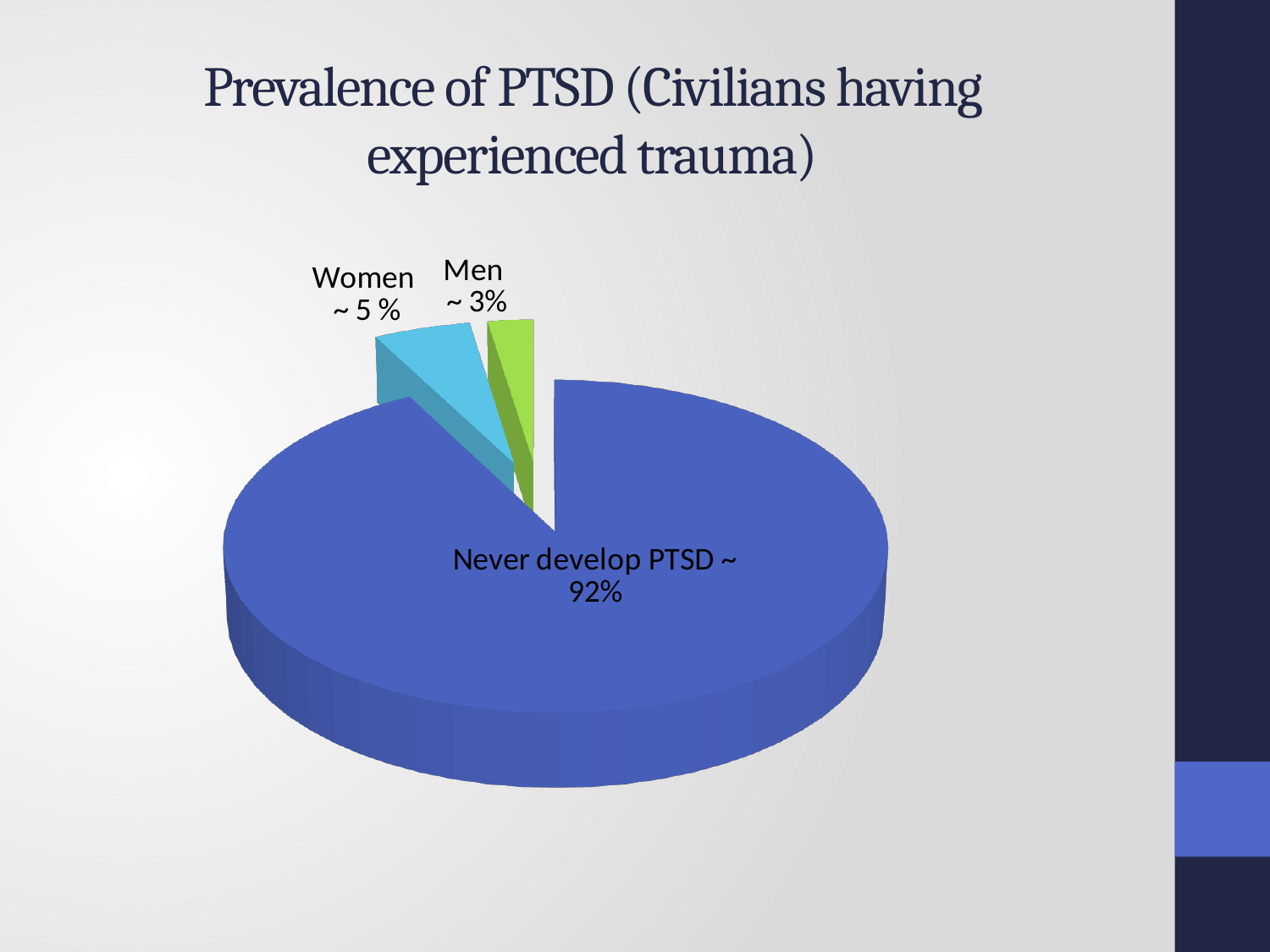
Which slice is larger, Never develop PTSD or Women? Never develop PTSD What colour is the Men slice of the pie chart? green Which slice is larger, Women or Men? Women What is the title of the slide? Prevalence of PTSD (Civilians having experienced trauma) Which slice of the pie chart is the largest? Never develop PTSD What percentage label is shown for the Women slice? ~ 5 % What percentage label is shown for the Men slice? ~ 3% How many slices does the pie chart have? 3 What percentage label is shown for the Never develop PTSD slice? ~ 92% Which slice of the pie chart is the smallest? Men What kind of chart is shown on the slide? pie chart